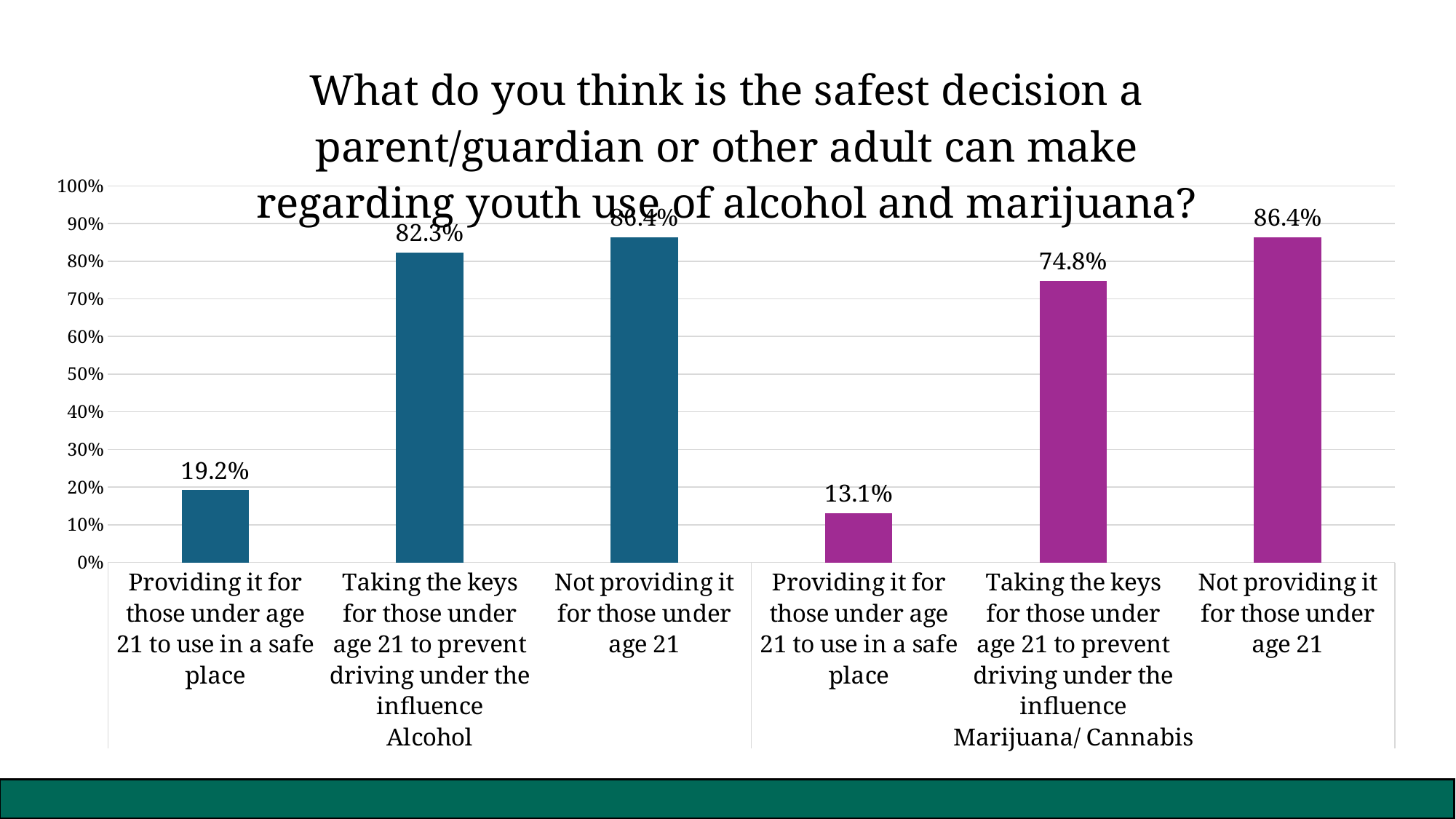
Is the Marijuana/ Cannabis value for "Providing it for those under age 21 to use in a safe place" greater or less than 20%? less What percentage chose "Taking the keys for those under age 21 to prevent driving under the influence" for Marijuana/ Cannabis? 74.8% What kind of chart is shown on the slide? Bar chart What percentage chose "Providing it for those under age 21 to use in a safe place" for Alcohol? 19.2% Which Marijuana/ Cannabis option has the lowest percentage? Providing it for those under age 21 to use in a safe place Which is larger: the Alcohol value for "Taking the keys" or the Marijuana/ Cannabis value for "Taking the keys"? Alcohol What is the difference between the Alcohol and Marijuana/ Cannabis percentages for "Providing it for those under age 21 to use in a safe place"? 6.1% What is the difference between the Alcohol and Marijuana/ Cannabis percentages for "Taking the keys for those under age 21 to prevent driving under the influence"? 7.5% Which Alcohol option has the highest percentage? Not providing it for those under age 21 What colour are the bars for the Marijuana/ Cannabis group? Purple How many bars are plotted on the chart? 6 What percentage chose "Not providing it for those under age 21" as the safest decision for Alcohol? 86.4%